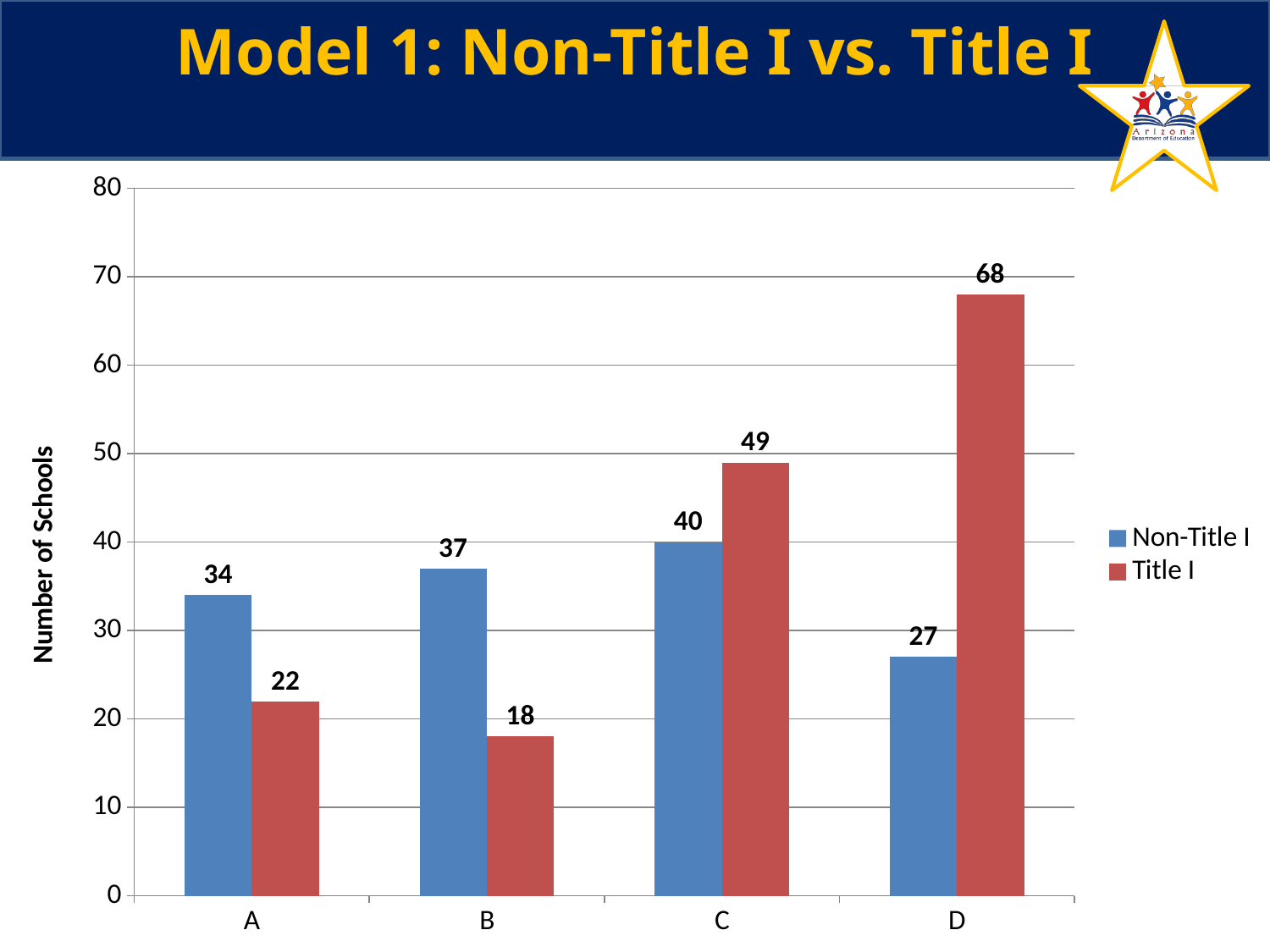
Is the value for Title I in category D greater or less than 60? greater What is the difference between Title I and Non-Title I schools in category C? 9 How many categories are shown on the x axis? 4 What is the number of Title I schools for category D? 68 What is the label of the y axis? Number of Schools Which category has the lowest number of Non-Title I schools? D What is the number of Non-Title I schools for category A? 34 What is the number of Title I schools for category B? 18 What kind of chart is shown on the slide? Bar chart How many series does the legend list? 2 In category B, which is larger: Non-Title I or Title I? Non-Title I Which category has the highest number of Title I schools? D